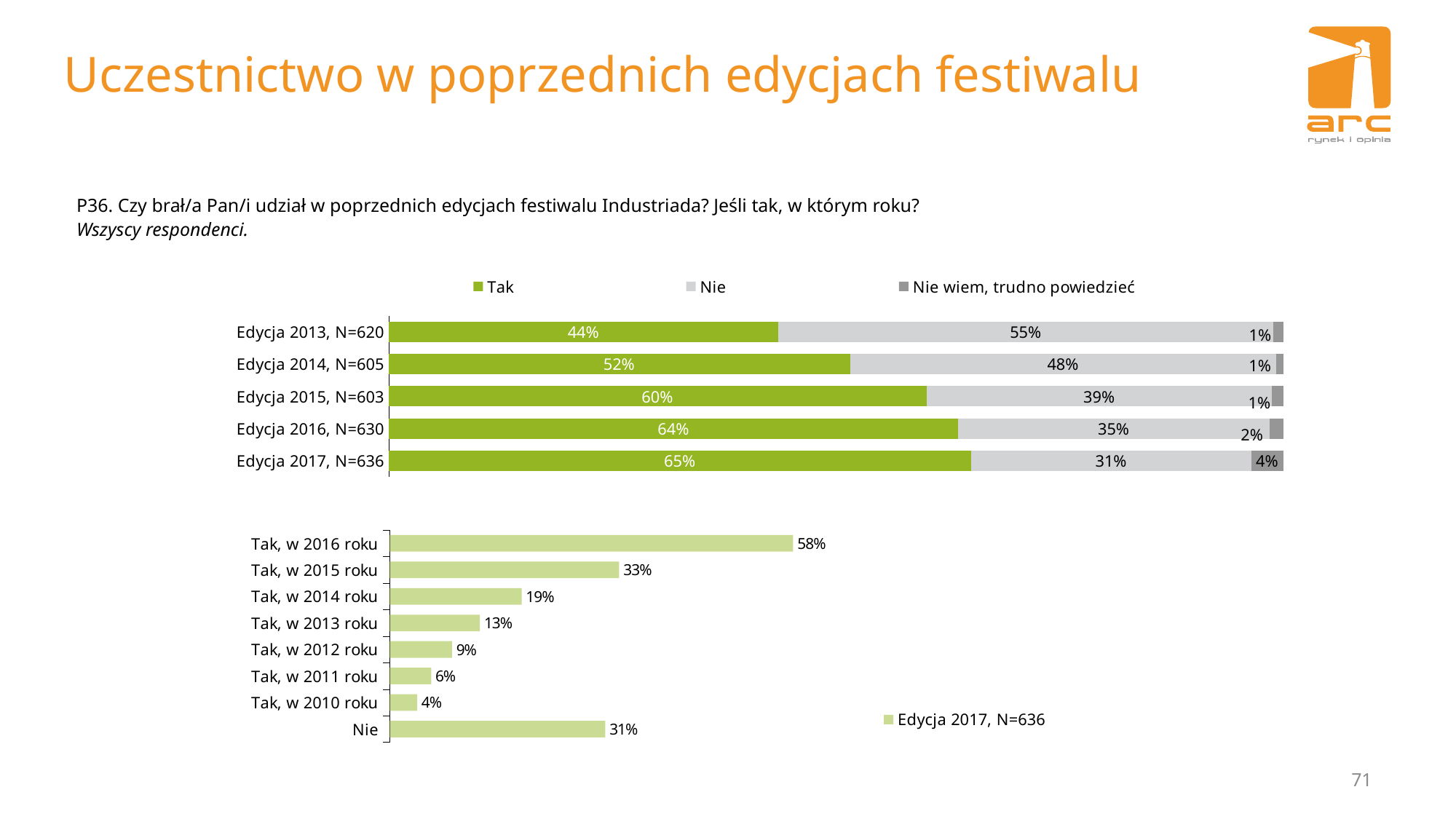
In the bottom bar chart, what is the value for 'Tak, w 2016 roku'? 58% In the top stacked bar chart, how many series does the legend list? 3 What type of chart is the bottom chart? bar chart In the bottom bar chart, which category has the lowest value? Tak, w 2010 roku In the bottom bar chart, which is larger: 'Tak, w 2015 roku' or 'Nie'? Tak, w 2015 roku In the bottom bar chart, how many categories are shown? 8 In the top stacked bar chart, which edition has the highest 'Tak' share? Edycja 2017, N=636 In the top stacked bar chart, what is the difference between the 'Tak' values for Edycja 2017 and Edycja 2013? 21 percentage points In the top stacked bar chart, does the 'Tak' share rise or fall from Edycja 2013 to Edycja 2017? rise In the top stacked bar chart, what is the 'Nie' value for Edycja 2013, N=620? 55% In the top stacked bar chart, which edition has the lowest 'Tak' share? Edycja 2013, N=620 In the top stacked bar chart, what is the 'Tak' value for Edycja 2017, N=636? 65%